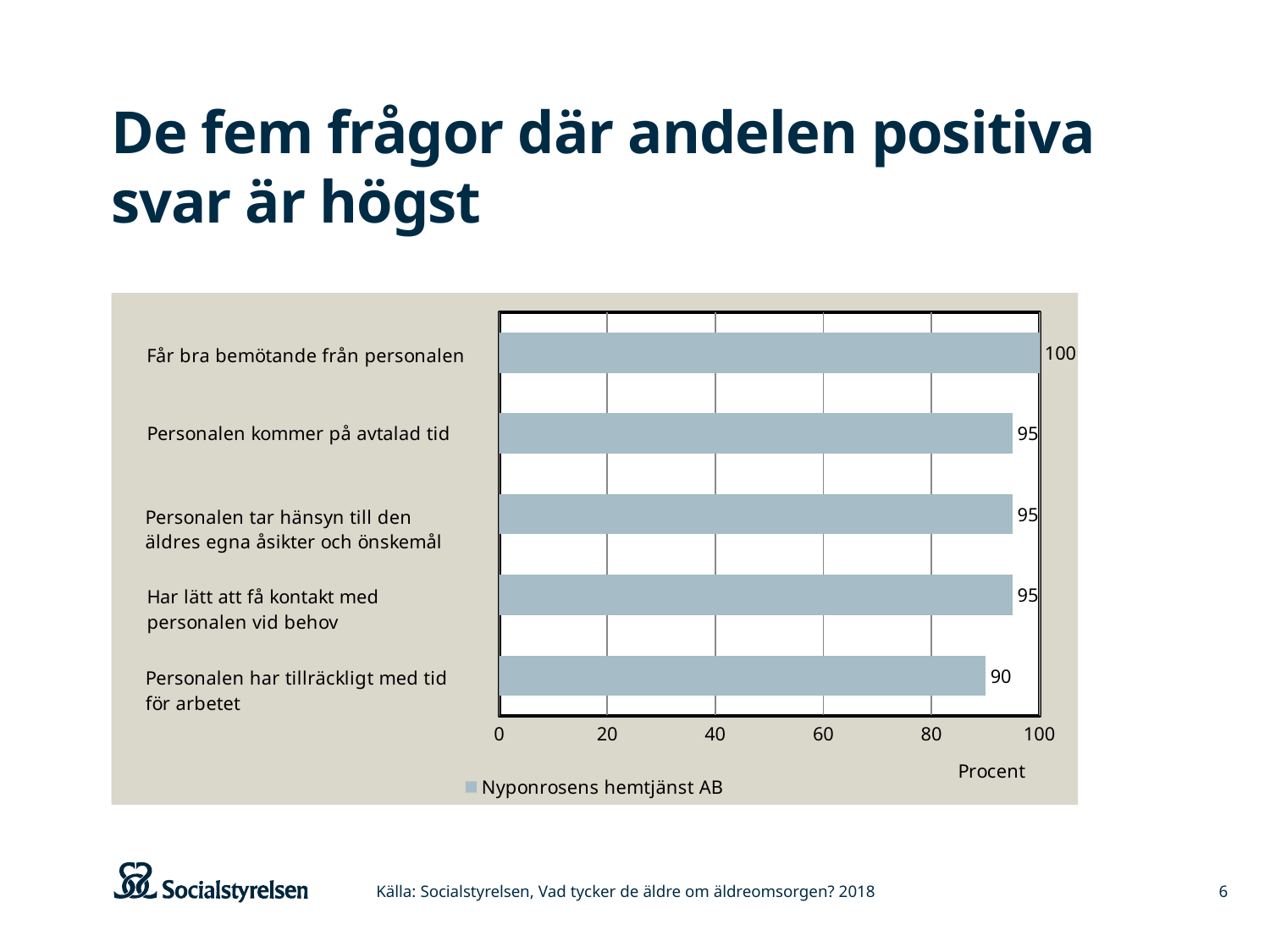
What is the difference between the values for "Får bra bemötande från personalen" and "Personalen har tillräckligt med tid för arbetet"? 10 What is the value for "Får bra bemötande från personalen"? 100 What kind of chart is shown on the slide? bar chart What is the value for "Personalen har tillräckligt med tid för arbetet"? 90 How many categories are shown in the chart? 5 What series name is shown in the legend? Nyponrosens hemtjänst AB How many series does the legend list? 1 Which is larger: the value for "Har lätt att få kontakt med personalen vid behov" or the value for "Personalen har tillräckligt med tid för arbetet"? Har lätt att få kontakt med personalen vid behov Which category has the highest value? Får bra bemötande från personalen What is the value for "Personalen kommer på avtalad tid"? 95 Is the value for "Personalen har tillräckligt med tid för arbetet" greater or less than 80? greater Which category has the lowest value? Personalen har tillräckligt med tid för arbetet